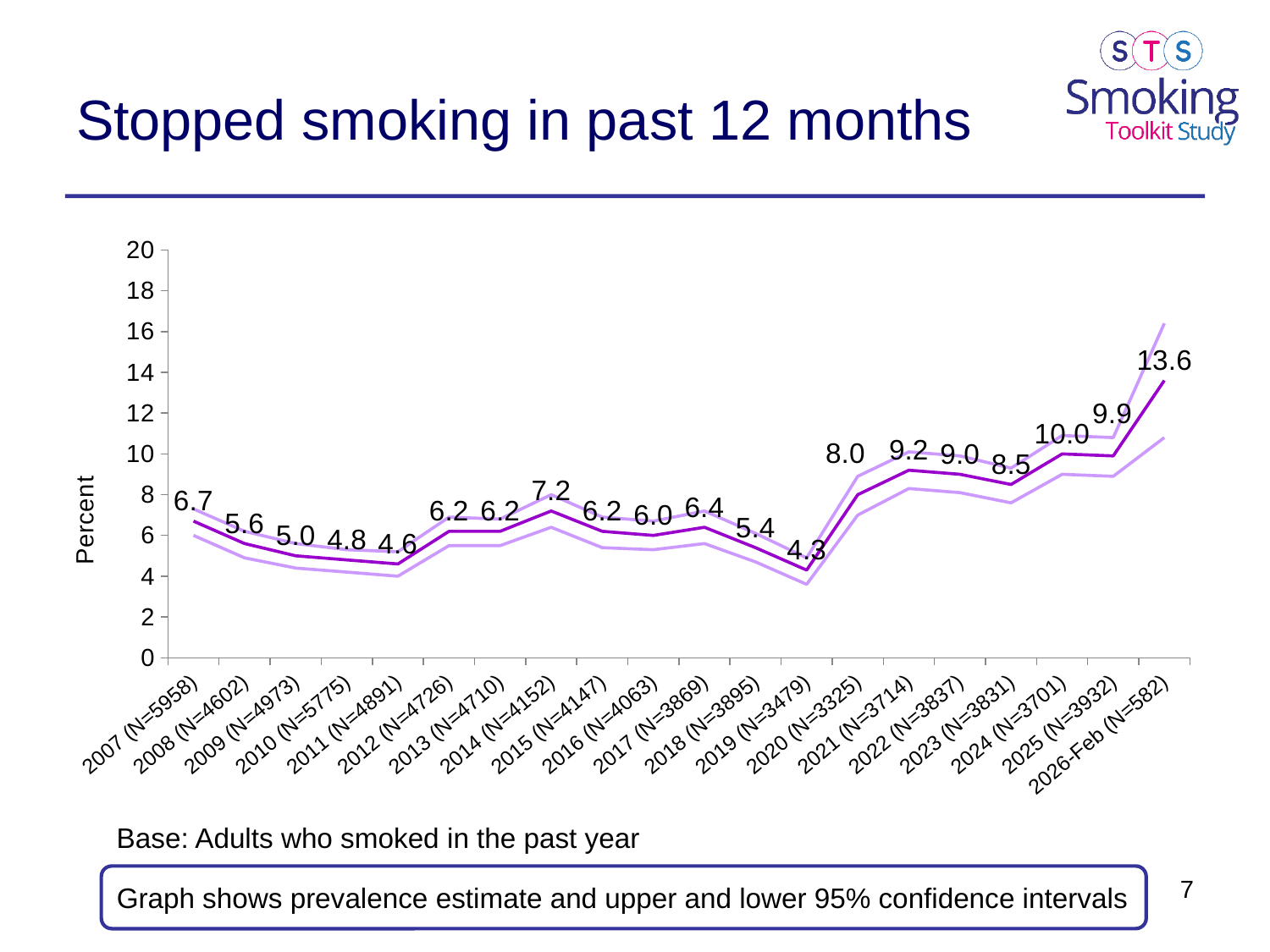
What is the label on the y axis? Percent What is the value for 2019 (N=3479)? 4.3 Which year has the lowest value? 2019 (N=3479) What is the difference between the values for 2020 (N=3325) and 2019 (N=3479)? 3.7 Which year has the highest value? 2026-Feb (N=582) Which is larger, the value for 2021 (N=3714) or the value for 2022 (N=3837)? 2021 (N=3714) How many years are plotted on the x axis? 20 What is the value for 2014 (N=4152)? 7.2 Is the value for 2024 (N=3701) greater or less than 8? greater What is the value for 2007 (N=5958)? 6.7 What kind of chart is shown on the slide? line chart What is the value for 2026-Feb (N=582)? 13.6